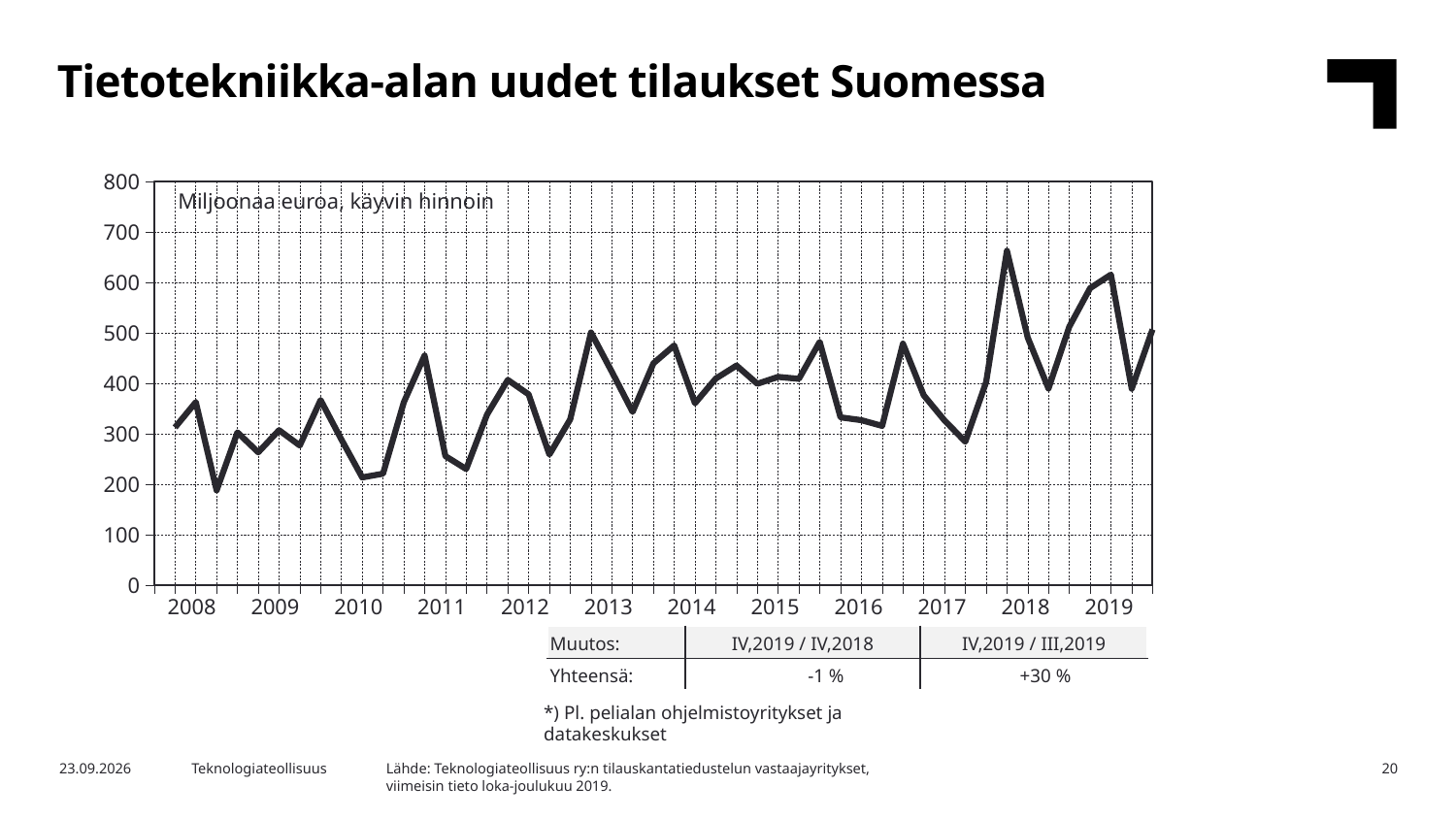
Is the highest value in 2019 greater or less than 500? greater In which year does the line reach its highest point? 2018 Is the lowest value in 2008 greater or less than 300? less Which is larger, the peak value in 2018 or the peak value in 2013? 2018 What change is given in the table for IV,2019 / IV,2018? -1 % Is the highest value in 2018 greater or less than 600? greater In which year does the line reach its lowest point? 2008 Does the line rise or fall from the low point in 2017 to the peak in 2018? rises What kind of chart is shown on the slide? line chart What unit is stated inside the chart area? Miljoonaa euroa, käyvin hinnoin How many years are labelled on the x axis of the chart? 12